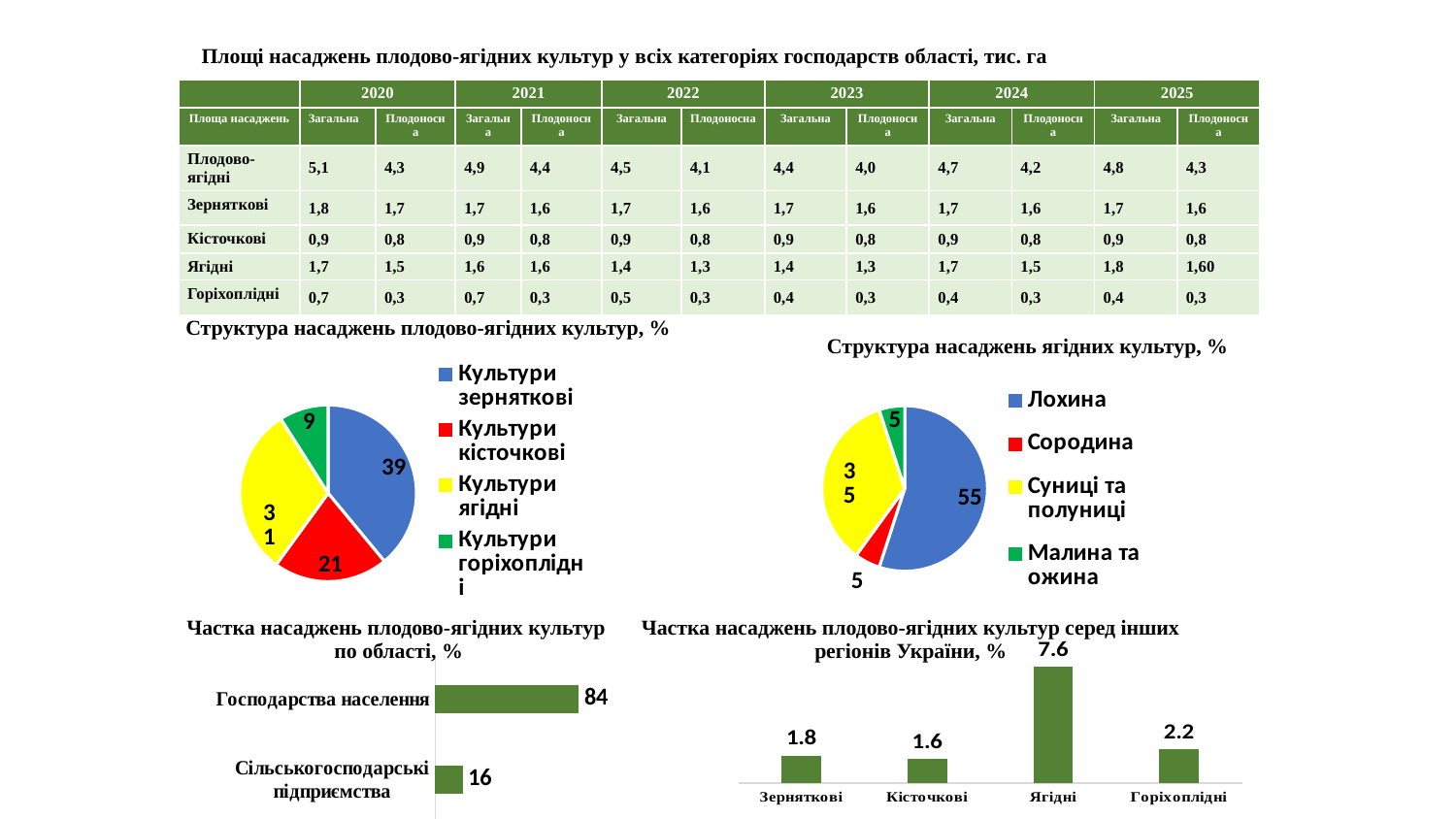
In the pie chart 'Структура насаджень плодово-ягідних культур, %', which category has the smallest slice? Культури горіхоплідні In the pie chart 'Структура насаджень ягідних культур, %', what is the value for Лохина? 55 In the chart 'Частка насаджень плодово-ягідних культур серед інших регіонів України, %', which category has the highest value? Ягідні In the chart 'Частка насаджень плодово-ягідних культур по області, %', what is the difference between Господарства населення and Сільськогосподарські підприємства? 68 In the pie chart 'Структура насаджень плодово-ягідних культур, %', what is the value for Культури зерняткові? 39 In the pie chart 'Структура насаджень ягідних культур, %', which is larger: Суниці та полуниці or Сородина? Суниці та полуниці In the pie chart 'Структура насаджень плодово-ягідних культур, %', what is the difference between Культури зерняткові and Культури кісточкові? 18 How many entries does the legend of the pie chart 'Структура насаджень плодово-ягідних культур, %' list? 4 In the pie chart 'Структура насаджень ягідних культур, %', which category has the largest slice? Лохина What kind of chart is 'Частка насаджень плодово-ягідних культур по області, %'? Bar chart In the chart 'Частка насаджень плодово-ягідних культур по області, %', what is the value for Господарства населення? 84 In the chart 'Частка насаджень плодово-ягідних культур серед інших регіонів України, %', what is the value for Горіхоплідні? 2.2